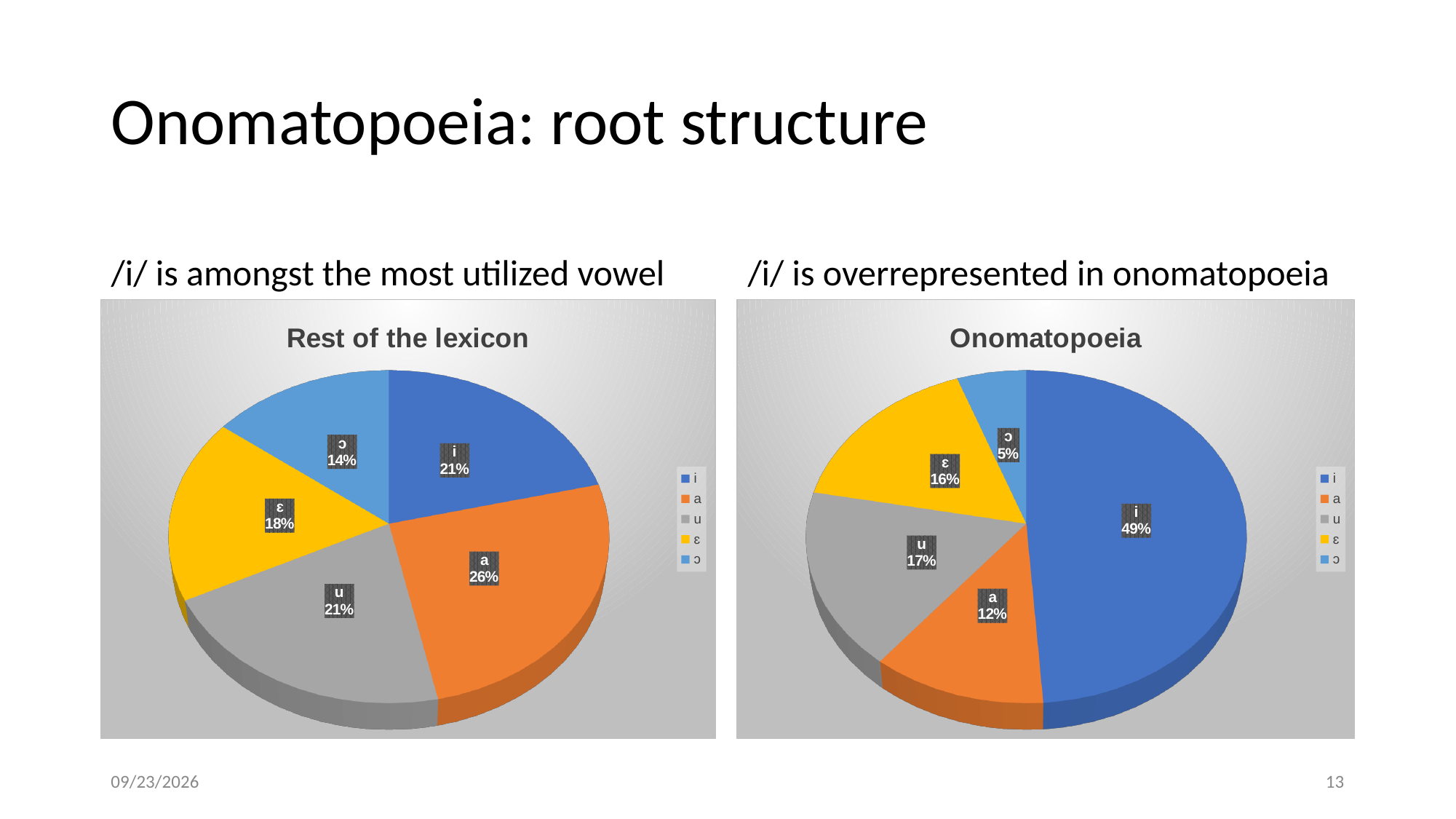
In the "Rest of the lexicon" chart, which is larger, the share for ɛ or the share for ɔ? ɛ In the "Rest of the lexicon" chart, what share does the ɔ slice have? 14% How many entries does the legend of the "Onomatopoeia" chart list? 5 In the "Onomatopoeia" chart, what share does the u slice have? 17% In the "Rest of the lexicon" chart, what share does the a slice have? 26% What kind of chart is the "Rest of the lexicon" chart? Pie chart How many slices does the "Onomatopoeia" chart have? 5 In the "Onomatopoeia" chart, what is the difference between the shares for i and a? 37% In the "Onomatopoeia" chart, what share does the i slice have? 49% What is the title of the chart on the left side of the slide? Rest of the lexicon In the "Onomatopoeia" chart, which vowel has the smallest slice? ɔ In the "Rest of the lexicon" chart, which vowel has the largest slice? a